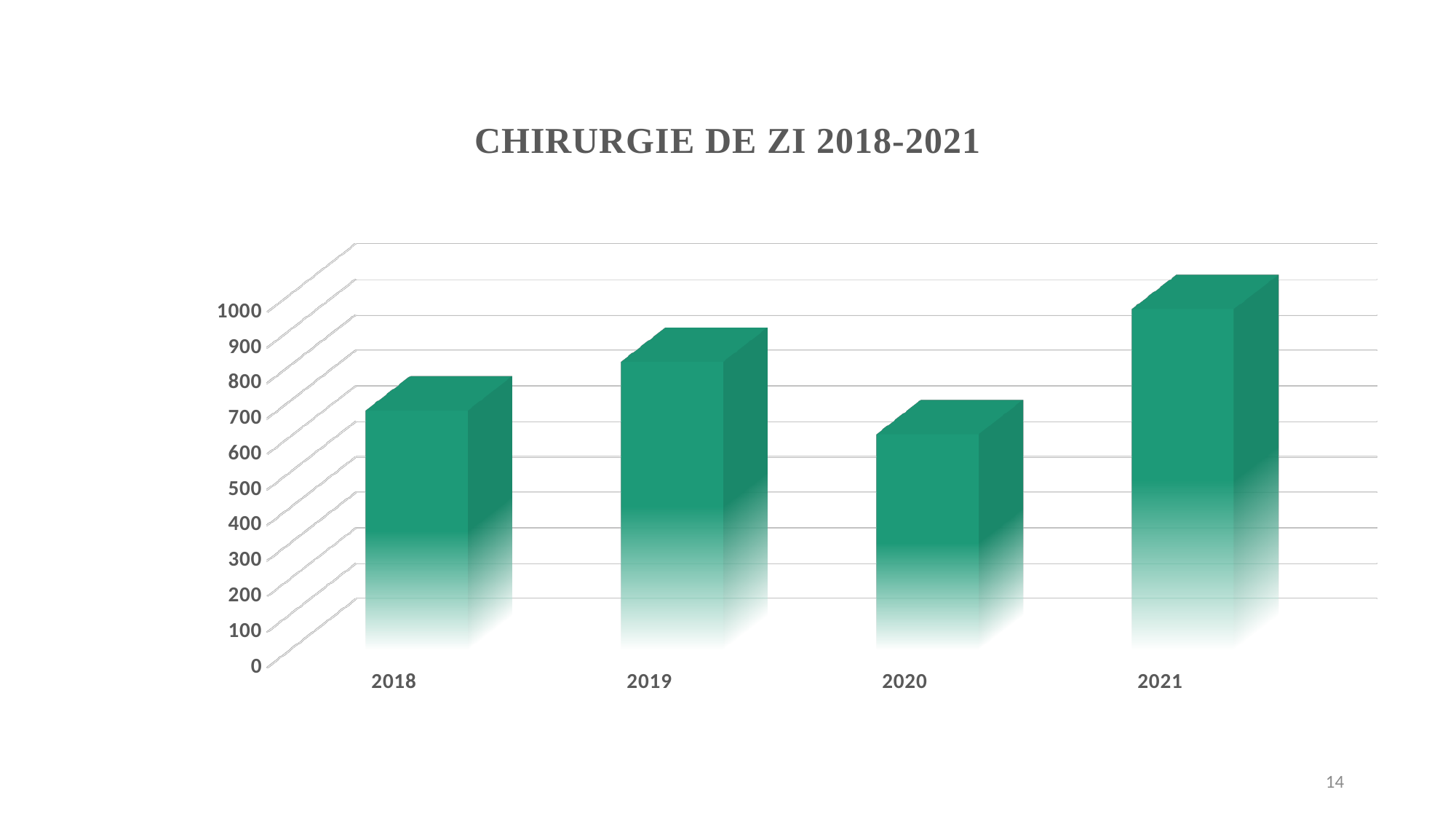
Is the value for 2021 greater or less than 900? greater What kind of chart is shown on the slide? bar chart Is the value for 2019 greater or less than 700? greater What is the title of the chart? CHIRURGIE DE ZI 2018-2021 Which is larger, the value for 2019 or the value for 2018? 2019 Is the value for 2018 greater or less than 800? less Does the value fall or rise from 2019 to 2020? fall Which year has the lowest value? 2020 Which year has the highest value? 2021 Which is larger, the value for 2020 or the value for 2019? 2019 How many years (categories) are plotted on the chart? 4